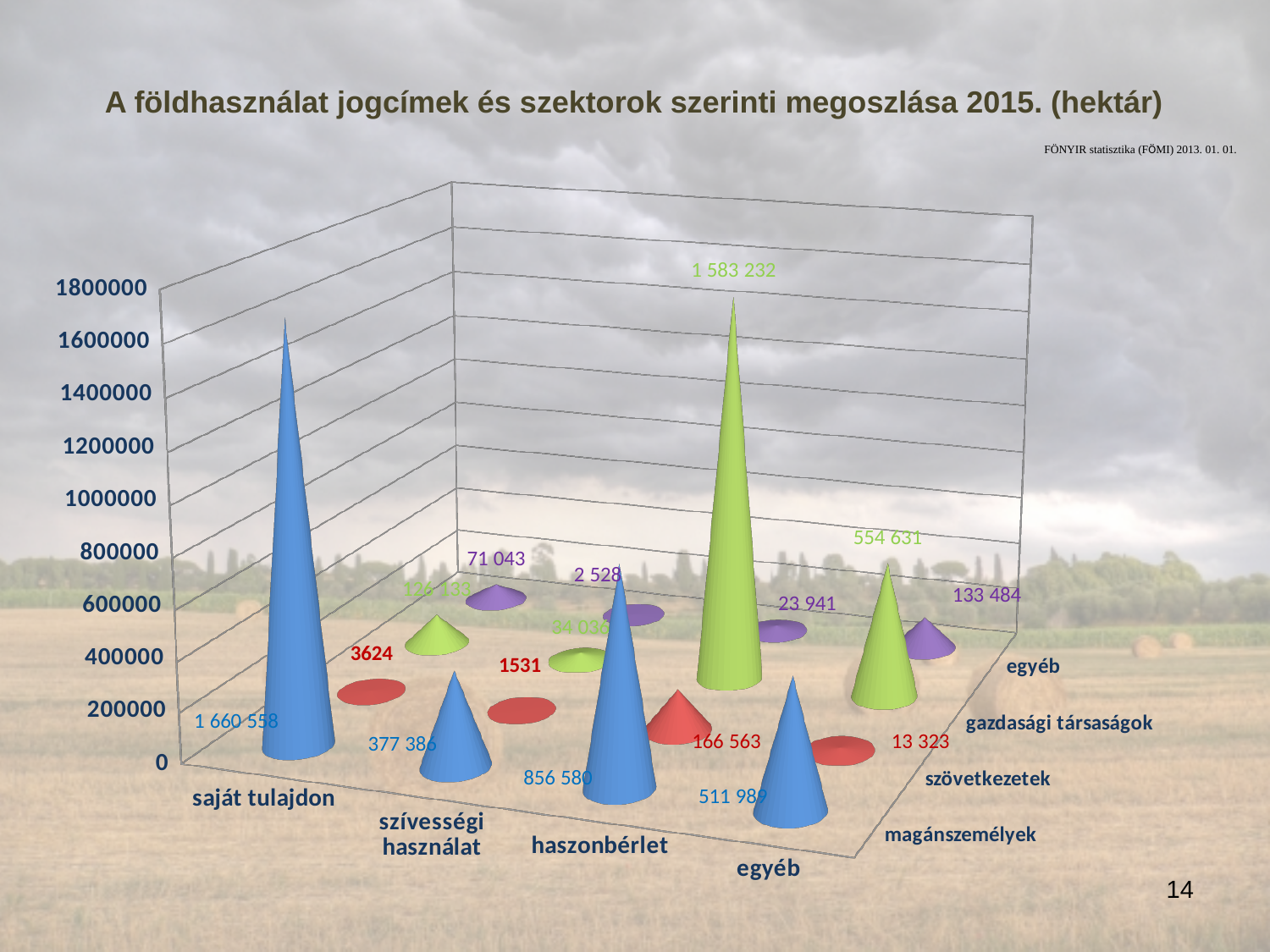
What is the difference between the magánszemélyek values for haszonbérlet and egyéb? 344 591 What is the value for egyéb (sector) under egyéb (title)? 133 484 How many sectors (series) are plotted in the chart? 4 Which is larger for haszonbérlet: the value for magánszemélyek or for gazdasági társaságok? gazdasági társaságok What is the value for szövetkezetek under haszonbérlet? 166 563 Which land-use title has the highest value for magánszemélyek? saját tulajdon What is the value for magánszemélyek under szívességi használat? 377 386 Which land-use title has the lowest value for szövetkezetek? szívességi használat What is the value for magánszemélyek under saját tulajdon? 1 660 558 What is the title of the chart? A földhasználat jogcímek és szektorok szerinti megoszlása 2015. (hektár) What is the value for gazdasági társaságok under haszonbérlet? 1 583 232 How many land-use title categories are shown along the x axis? 4